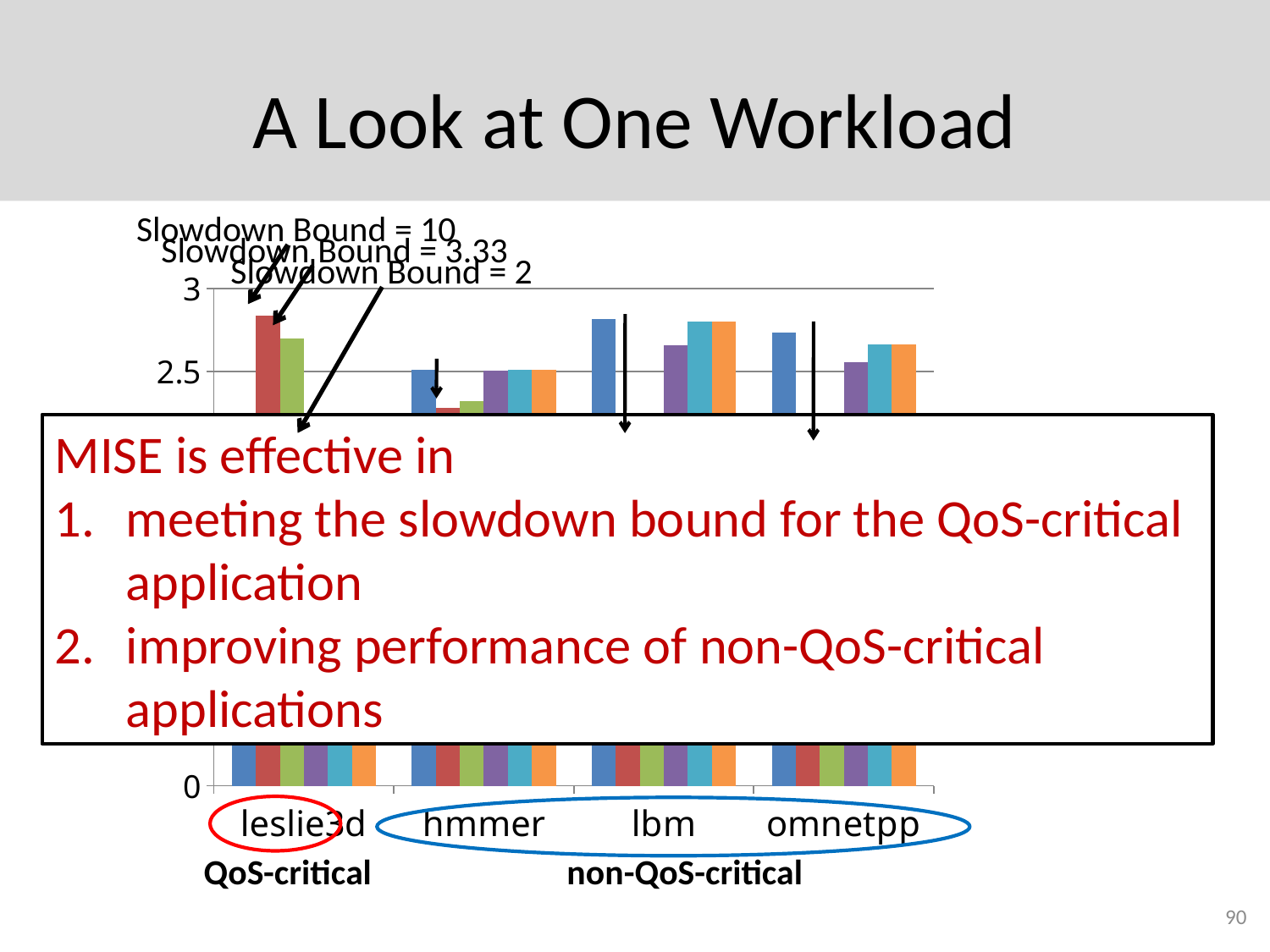
Is the tallest bar for leslie3d greater or less than 2.5? greater Is the tallest bar for omnetpp greater or less than 3? less What is the highest value shown on the y axis of the chart? 3 Is the tallest bar for lbm greater or less than 2.5? greater How many categories are shown on the x axis of the chart? 4 Which category on the x axis is labelled as QoS-critical? leslie3d What kind of chart is shown on the slide? bar chart